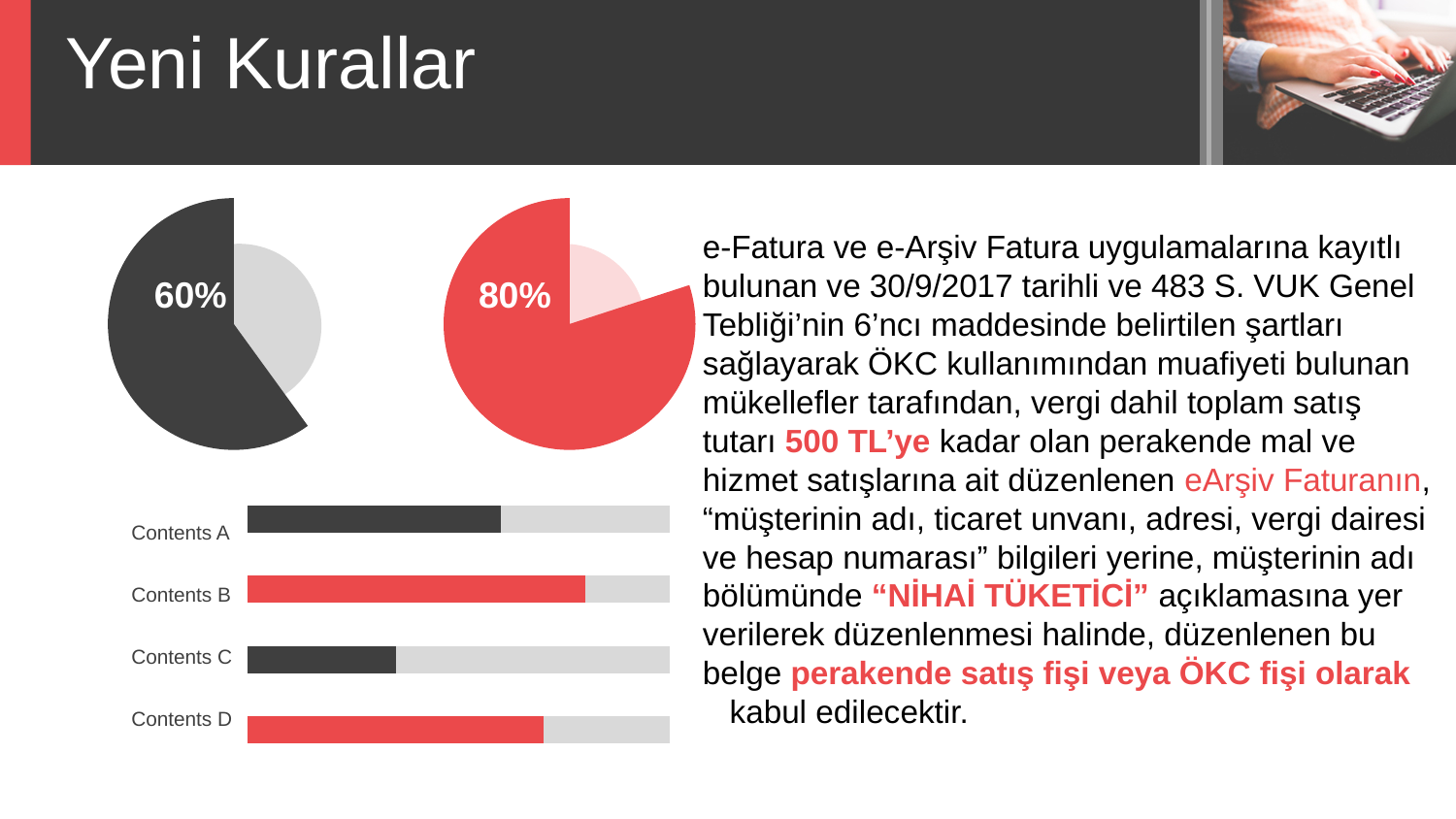
What kind of chart is the chart at the bottom left of the slide with Contents A to D? bar chart How many slices does the left pie chart have? 2 In the bar chart at the bottom left, which category has the shortest bar? Contents C In the bar chart at the bottom left, what colour is the bar for Contents D? red What is the difference between the share labelled on the right pie chart and the share labelled on the left pie chart? 20 percentage points How many categories does the bar chart at the bottom left of the slide show? 4 In the bar chart at the bottom left, which bar is longer, Contents B or Contents D? Contents B In the bar chart at the bottom left, which category has the longest bar? Contents B Which pie chart shows the larger labelled share, the left one or the right one? the right one In the right pie chart, what share does the red slice represent? 80% In the left pie chart, what share does the dark slice represent? 60% In the bar chart at the bottom left, which bar is longer, Contents A or Contents C? Contents A